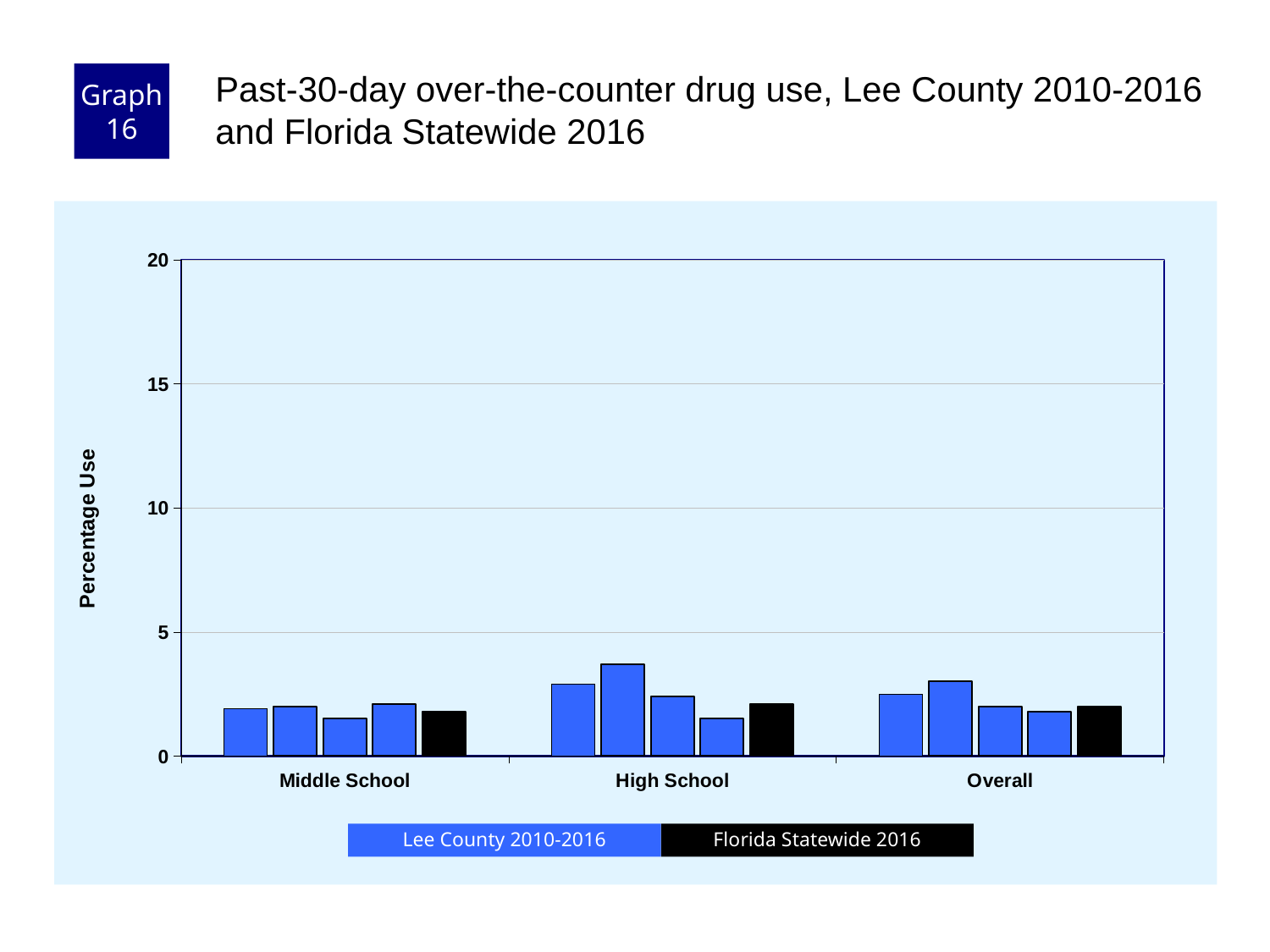
Is the tallest Lee County 2010-2016 bar for High School greater or less than 5? less Which category contains the shortest Florida Statewide 2016 bar? Middle School How many categories are shown on the x axis? 3 What is the label on the y axis? Percentage Use Are any bars in the chart greater than 5? No What are the two series named in the legend? Lee County 2010-2016 and Florida Statewide 2016 Which category contains the tallest bar in the chart? High School Is the tallest Lee County 2010-2016 bar for Middle School greater or less than 5? less What kind of chart is shown on the slide? bar chart How many series does the legend list? 2